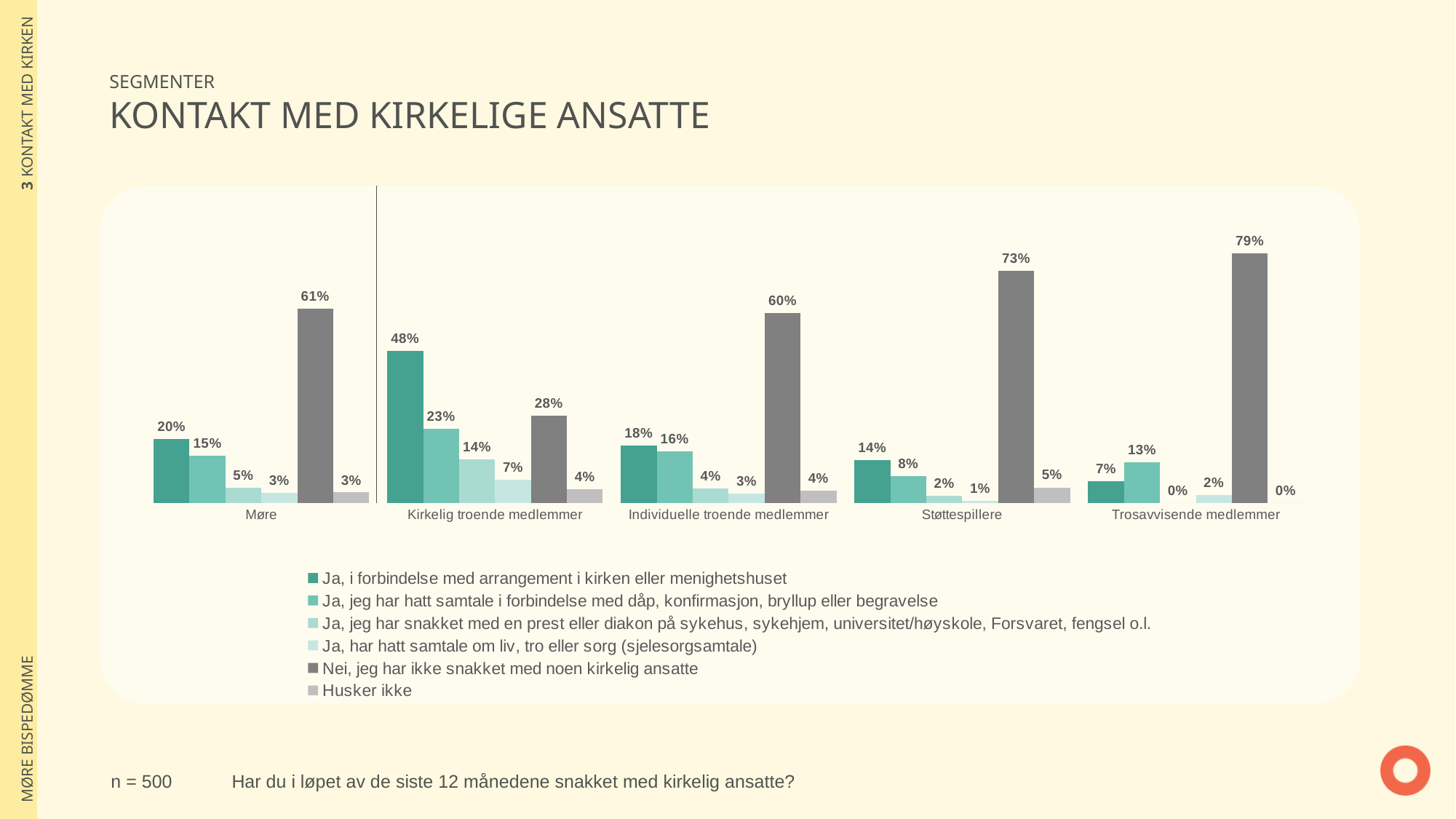
Which is larger for Individuelle troende medlemmer: "Ja, i forbindelse med arrangement i kirken eller menighetshuset" or "Ja, jeg har hatt samtale i forbindelse med dåp, konfirmasjon, bryllup eller begravelse"? Ja, i forbindelse med arrangement i kirken eller menighetshuset Which segment has the highest value for "Nei, jeg har ikke snakket med noen kirkelig ansatte"? Trosavvisende medlemmer Which segment has the lowest value for "Ja, i forbindelse med arrangement i kirken eller menighetshuset"? Trosavvisende medlemmer What is the value of "Husker ikke" for Støttespillere? 5% What percentage of Møre respondents answered "Nei, jeg har ikke snakket med noen kirkelig ansatte"? 61% What is the difference between the "Nei, jeg har ikke snakket med noen kirkelig ansatte" values for Støttespillere and Kirkelig troende medlemmer? 45 percentage points What kind of chart is shown on the slide? Bar chart What percentage of Trosavvisende medlemmer answered "Ja, jeg har hatt samtale i forbindelse med dåp, konfirmasjon, bryllup eller begravelse"? 13% What is the sample size (n) stated on the slide? n = 500 What is the value for "Ja, i forbindelse med arrangement i kirken eller menighetshuset" among Kirkelig troende medlemmer? 48% How many segments (categories) are shown on the x axis of the chart? 5 How many series does the legend list? 6